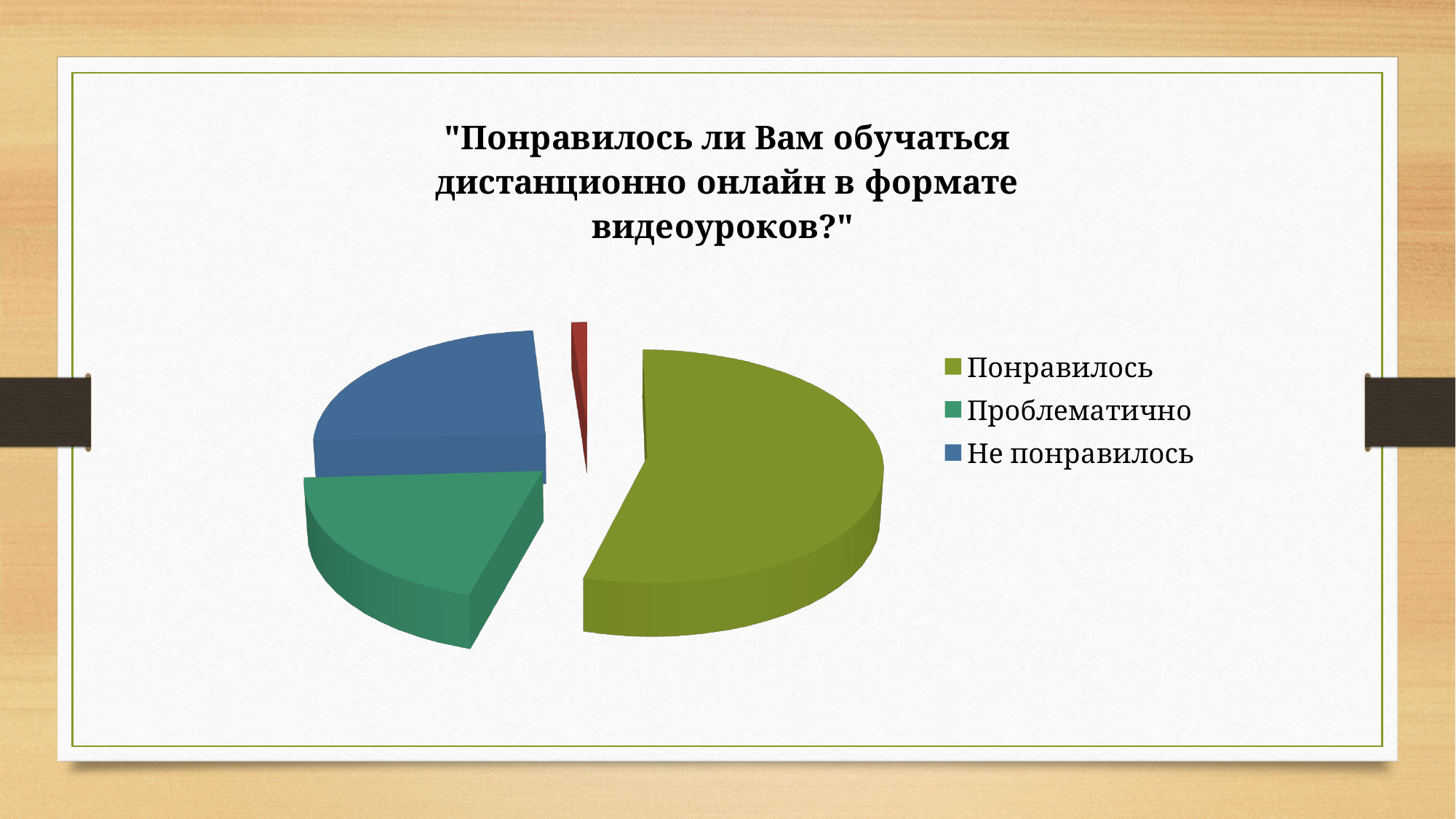
Which slice is larger, Понравилось or Не понравилось? Понравилось What colour is the slice for Не понравилось? Blue Which slice is larger, Понравилось or Проблематично? Понравилось What is the title of the chart? "Понравилось ли Вам обучаться дистанционно онлайн в формате видеоуроков?" Which category has the largest slice of the pie? Понравилось What kind of chart is shown on the slide? Pie chart How many entries does the chart legend list? 3